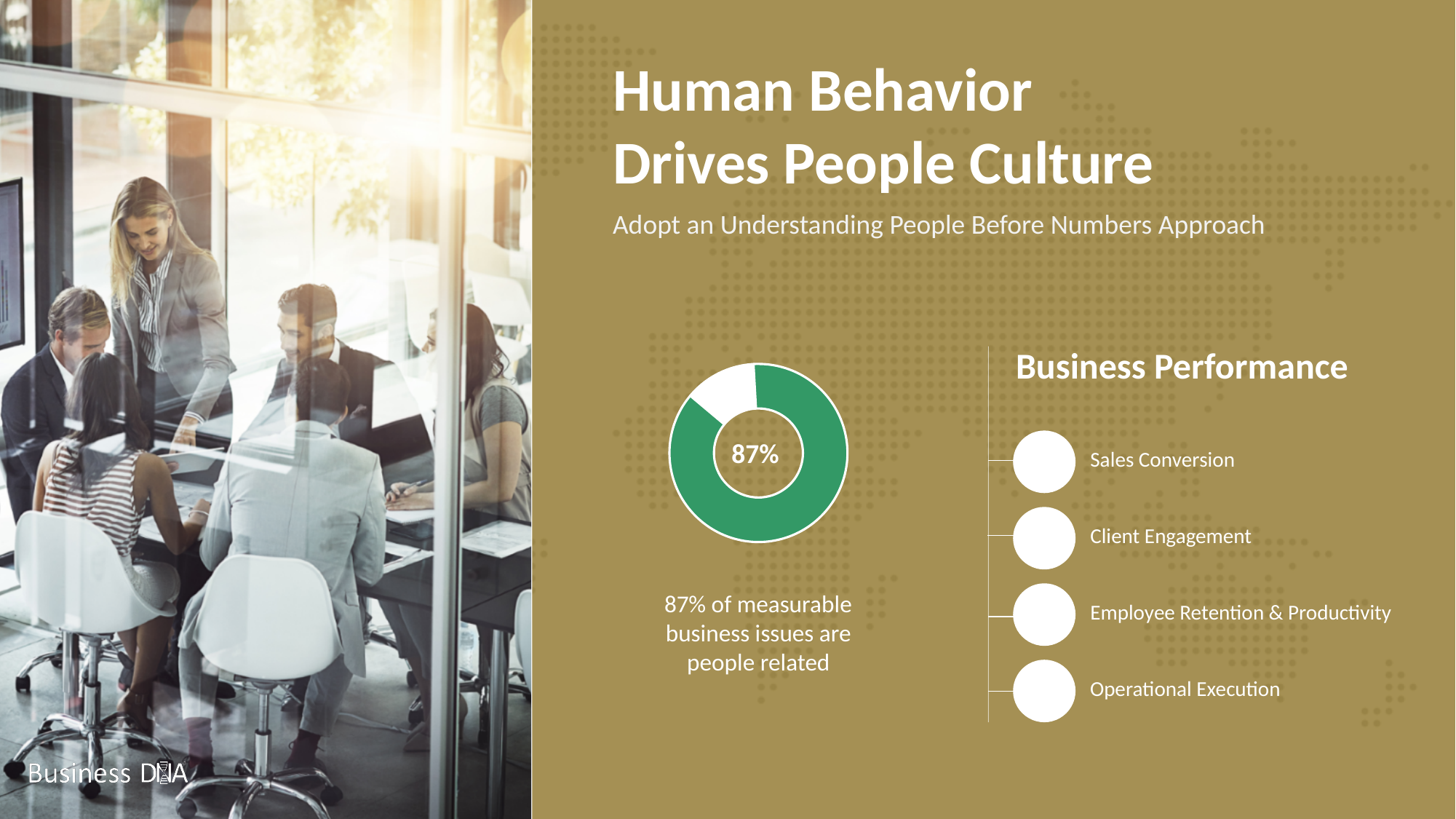
How many slices does the doughnut chart have? 2 Is the value shown by the green slice of the doughnut chart greater or less than 50%? greater According to the caption under the doughnut chart, what does the 87% represent? Measurable business issues that are people related What colour is the larger slice of the doughnut chart? Green What share of the doughnut chart does the green slice represent? 87% What percentage is printed in the centre of the doughnut chart? 87% What kind of chart is shown on the slide? Doughnut (pie) chart Which slice of the doughnut chart is larger, the green one or the white one? The green one Is the value shown by the white slice of the doughnut chart greater or less than 25%? less